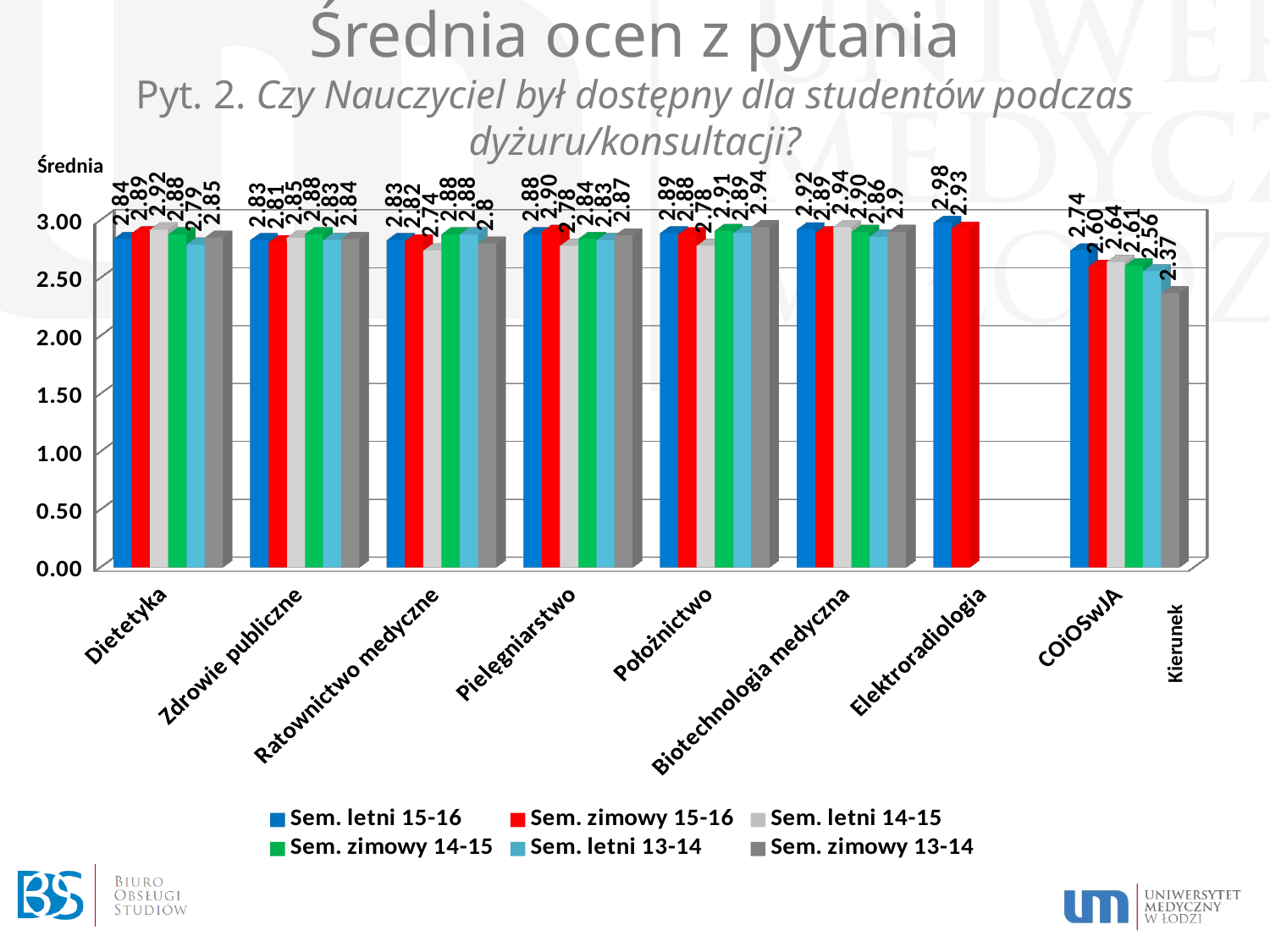
Which category has the highest value in the Sem. letni 15-16 series? Elektroradiologia What kind of chart is shown on the slide? Bar chart How many categories (kierunki) are shown on the x axis? 8 What is the difference between the Sem. letni 15-16 and Sem. zimowy 13-14 values for COiOSwJA? 0.37 What is the value for COiOSwJA in the Sem. zimowy 13-14 series? 2.37 How many series does the legend list? 6 What is the value for Dietetyka in the Sem. letni 14-15 series? 2.92 Which series is shown in red in the legend? Sem. zimowy 15-16 What is the value for Elektroradiologia in the Sem. letni 15-16 series? 2.98 Which category has the lowest value in the Sem. zimowy 15-16 series? COiOSwJA What is the value for Ratownictwo medyczne in the Sem. letni 14-15 series? 2.74 Which is larger for Pielęgniarstwo: the Sem. zimowy 15-16 value or the Sem. letni 14-15 value? Sem. zimowy 15-16